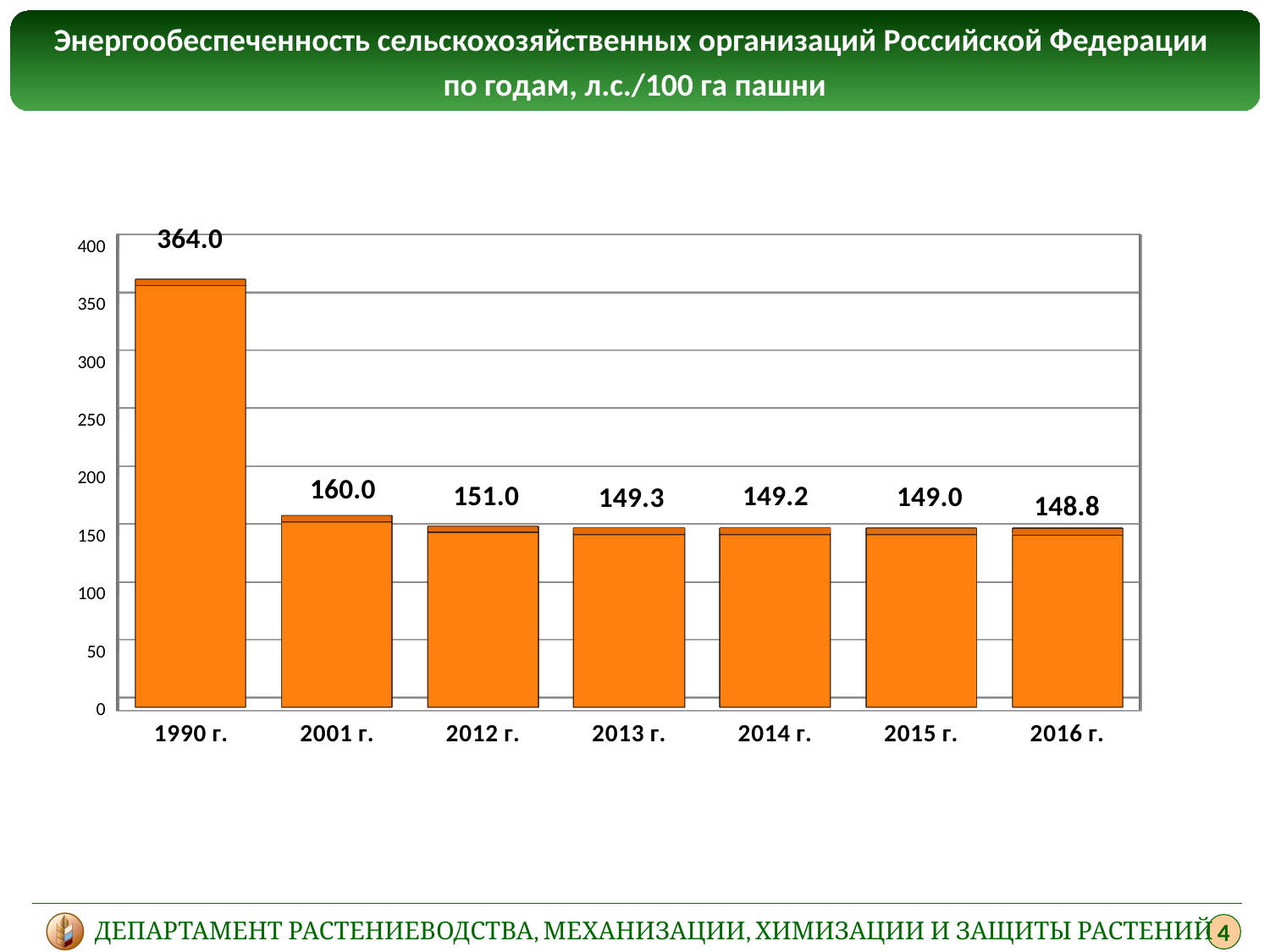
What is the value for 2013 г.? 149.3 What is the difference between the values for 1990 г. and 2001 г.? 204.0 What is the difference between the values for 2001 г. and 2012 г.? 9.0 What is the value for 2016 г.? 148.8 What kind of chart is shown on the slide? bar chart Which year has the lowest value? 2016 г. What is the value for 1990 г.? 364.0 Which is larger, the value for 2001 г. or the value for 2014 г.? 2001 г. Which year has the highest value? 1990 г. Is the value for 1990 г. greater or less than 350? greater Do the values rise or fall from 1990 г. to 2016 г.? fall How many years are shown on the x axis? 7